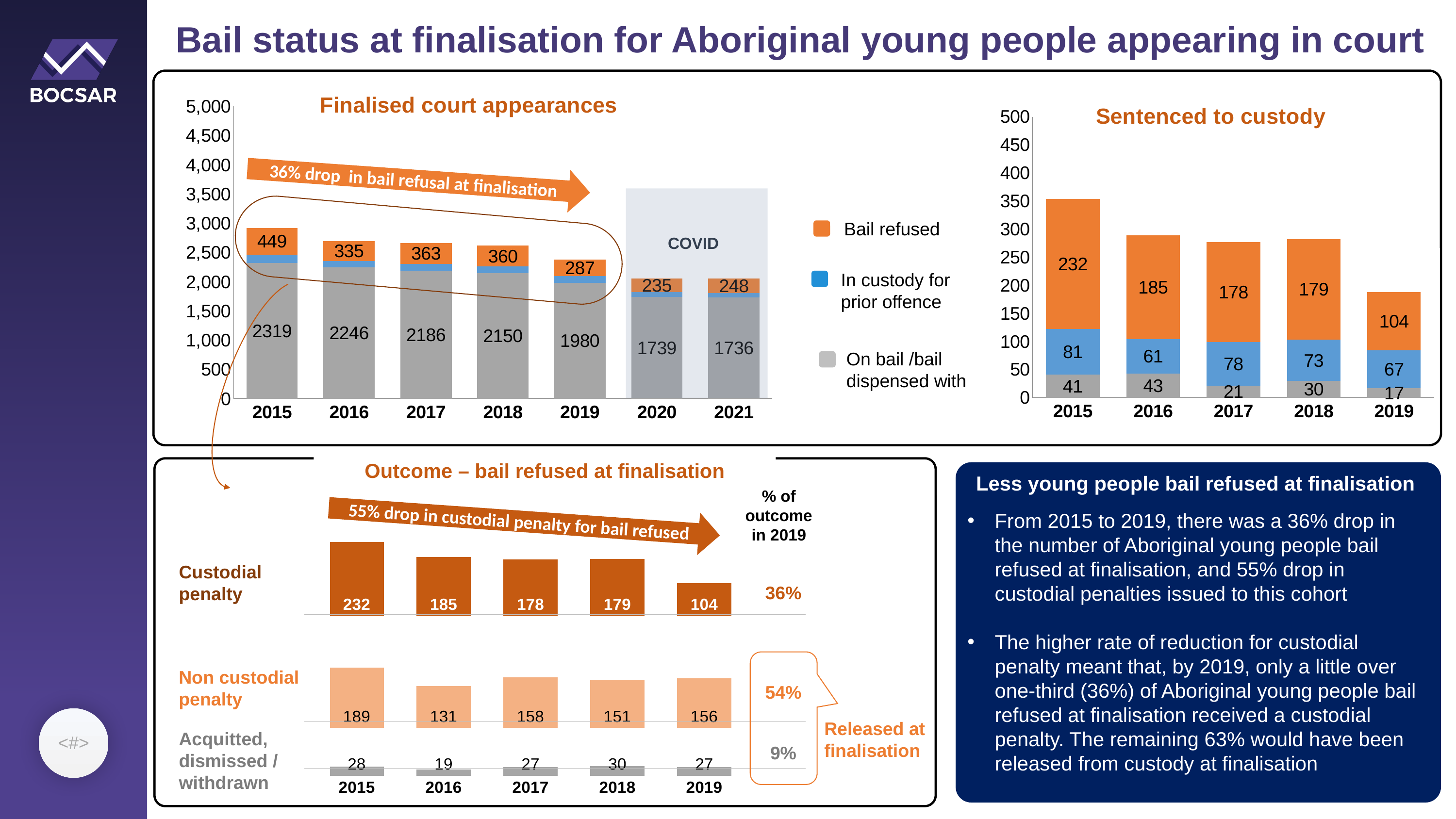
What kind of chart is 'Sentenced to custody'? Stacked bar chart In the 'Sentenced to custody' chart, what is the value of the grey segment for 2017? 21 In the 'Outcome – bail refused at finalisation' chart, which is larger in 2019: 'Custodial penalty' or 'Non custodial penalty'? Non custodial penalty In the 'Sentenced to custody' chart, what is the total of the stacked bar for 2019? 188 In the 'Finalised court appearances' chart, which year has the highest 'Bail refused' value? 2015 In the 'Finalised court appearances' chart, how many years are shown on the x axis? 7 In the 'Finalised court appearances' chart, what is the 'Bail refused' value for 2015? 449 In the 'Outcome – bail refused at finalisation' chart, what is the 'Non custodial penalty' value for 2017? 158 In the 'Finalised court appearances' chart, what is the 'On bail / bail dispensed with' value for 2021? 1736 In the 'Finalised court appearances' chart, how many series does the legend list? 3 In the 'Sentenced to custody' chart, is the total for 2015 greater or less than 300? greater In the 'Finalised court appearances' chart, what is the difference between the 'Bail refused' values for 2015 and 2019? 162